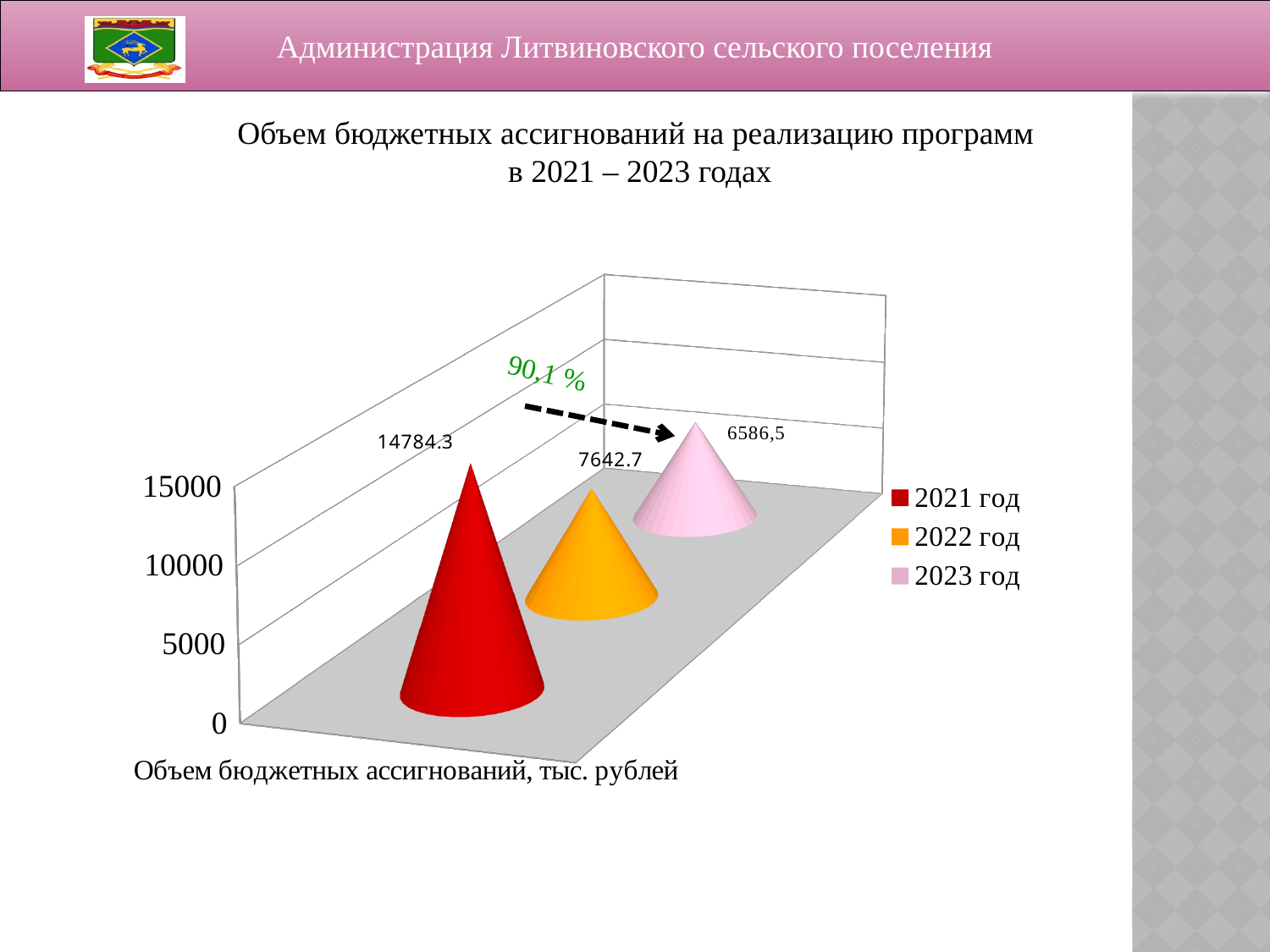
What is the difference between the values for 2022 год and 2023 год? 1056.2 What is the difference between the values for 2021 год and 2022 год? 7141.6 Do the values rise or fall from 2021 to 2023? fall What percentage is written next to the dashed arrow on the chart? 90,1 % How many series does the legend list? 3 Which year has the highest value? 2021 год Which is larger, the value for 2022 год or 2023 год? 2022 год What is the value for 2021 год? 14784.3 What is the value for 2022 год? 7642.7 Is the value for 2022 год greater or less than 10000? less What is the value for 2023 год? 6586,5 Which year has the lowest value? 2023 год